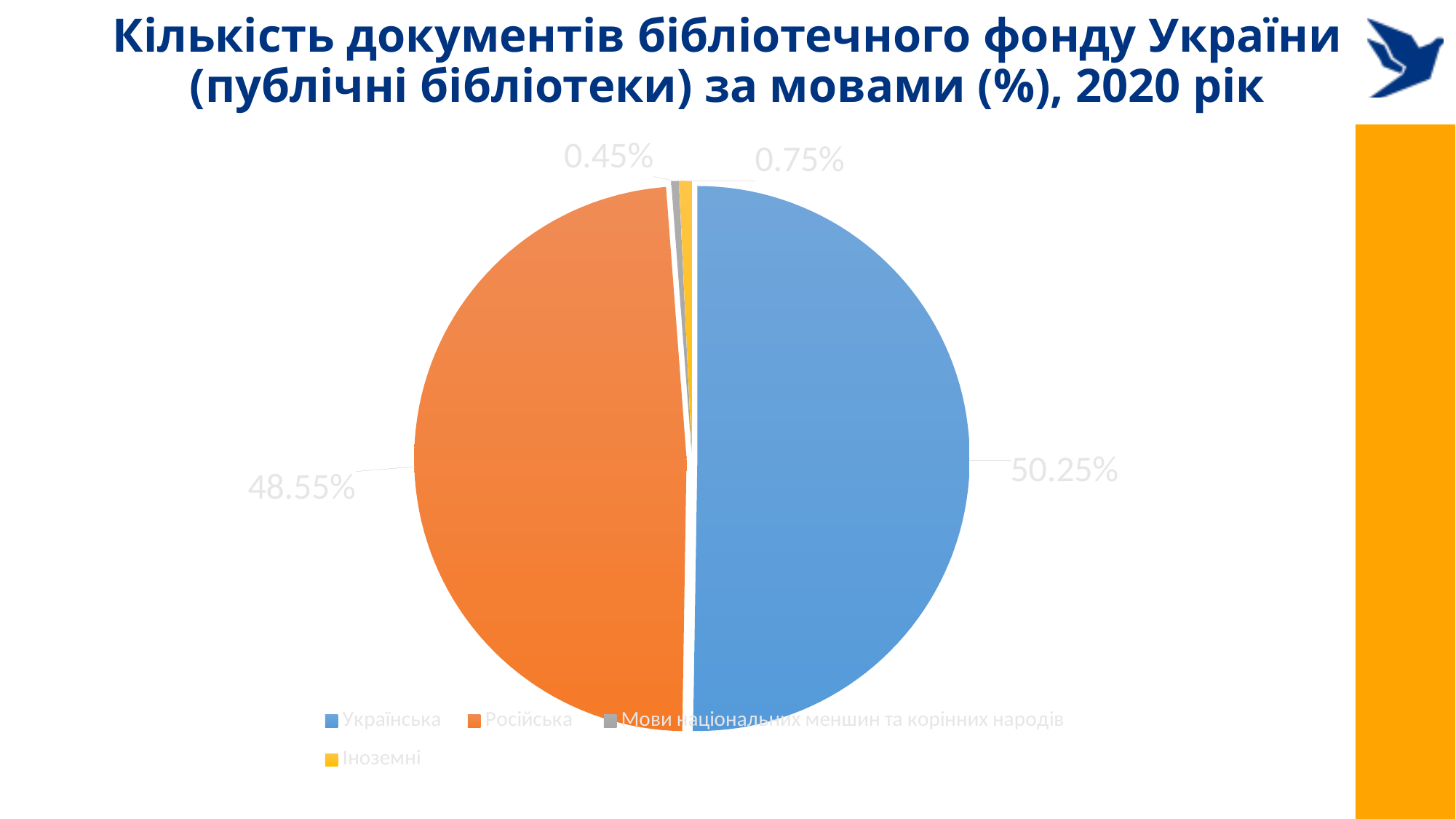
Which category has the smallest slice of the pie? Мови національних меншин та корінних народів Which category has the largest slice of the pie? Українська What is the difference between the shares of Українська and Російська? 1.70% Which is larger, the share of Іноземні or the share of Мови національних меншин та корінних народів? Іноземні What colour is the slice for Російська? orange What share of the pie does Українська have? 50.25% What share of the pie does Мови національних меншин та корінних народів have? 0.45% What share of the pie does Іноземні have? 0.75% How many categories does the legend list? 4 What year does the chart title refer to? 2020 What kind of chart is shown on the slide? pie chart What share of the pie does Російська have? 48.55%